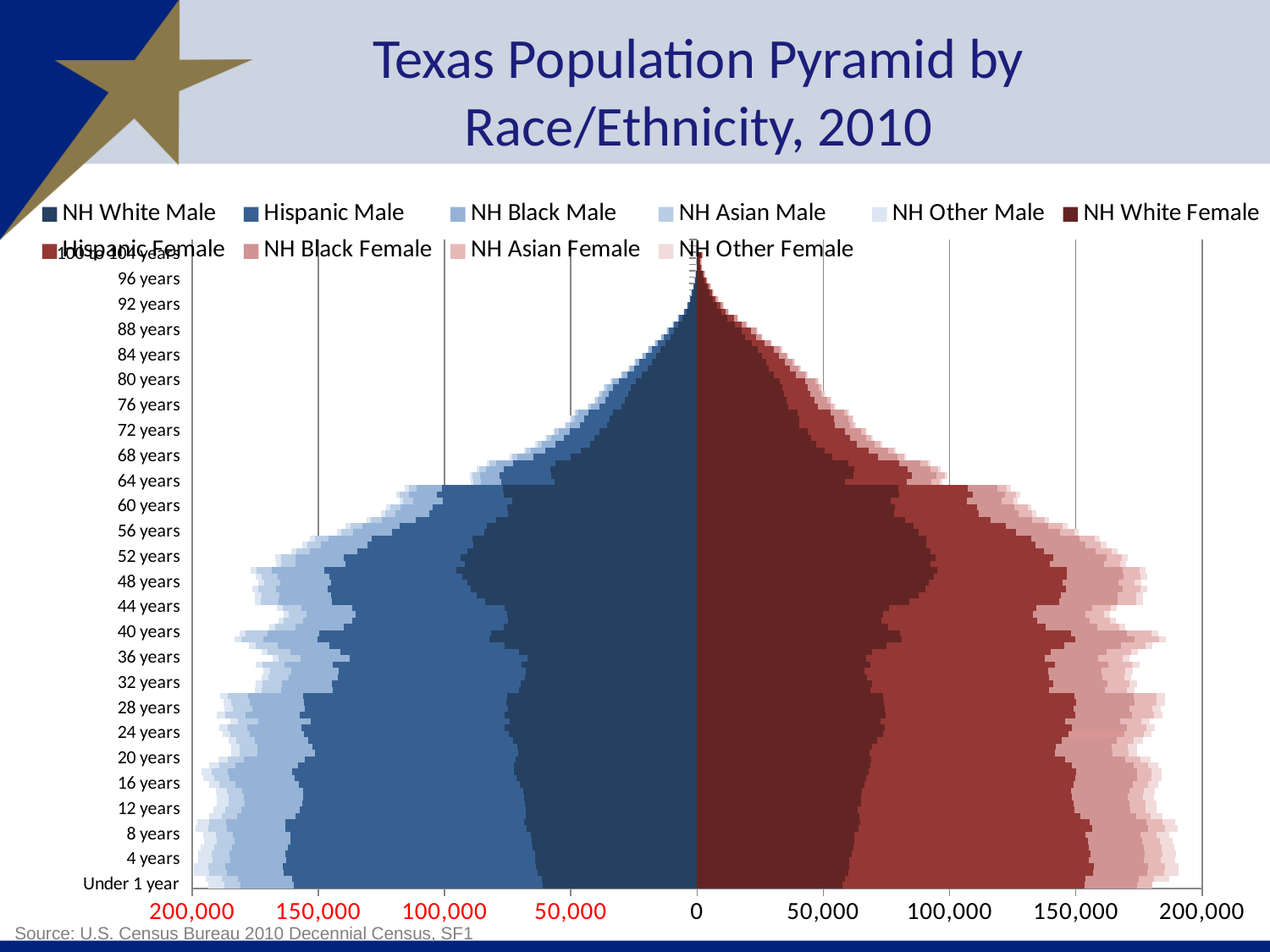
Is the total male population for the Under 1 year age group greater or less than 150,000? greater How many series does the legend list? 10 Which age group has a larger total female population, Under 1 year or 96 years? Under 1 year Is the total female population for the Under 1 year age group greater or less than 150,000? greater What is the title of the chart? Texas Population Pyramid by Race/Ethnicity, 2010 As age increases from Under 1 year to 100 to 104 years, do the total bar lengths generally increase or decrease? decrease Is the total female population for the 88 years age group greater or less than 50,000? less Which age group has a larger total male population, 20 years or 64 years? 20 years What kind of chart is shown on the slide? Bar chart (population pyramid) What source is cited for the chart data? U.S. Census Bureau 2010 Decennial Census, SF1